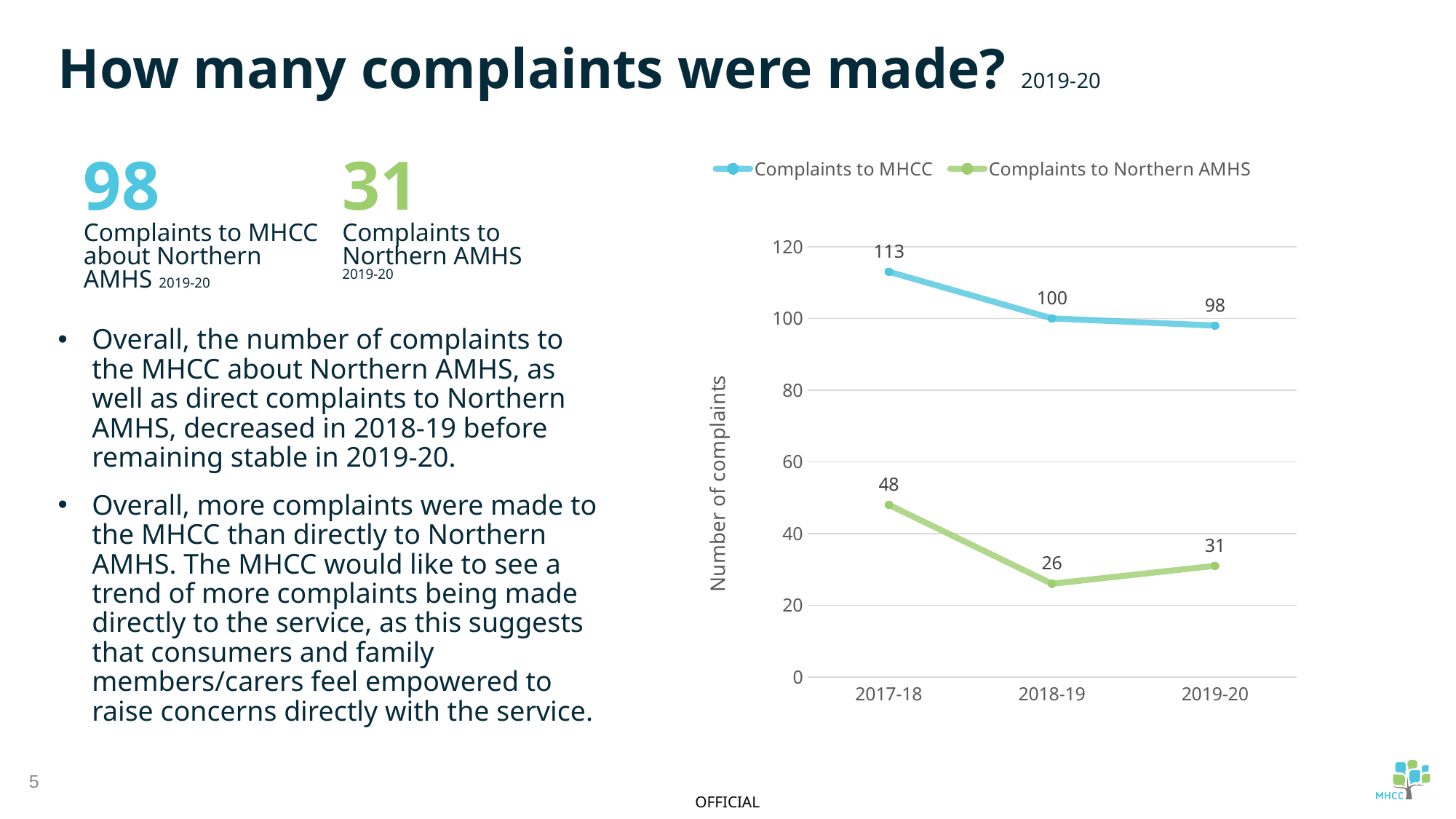
What is the value for Complaints to Northern AMHS in 2018-19? 26 What is the value for Complaints to MHCC in 2019-20? 98 Which is larger in 2017-18: Complaints to MHCC or Complaints to Northern AMHS? Complaints to MHCC What is the label on the vertical axis of the chart? Number of complaints In which year is the value for Complaints to Northern AMHS lowest? 2018-19 What is the difference between Complaints to MHCC and Complaints to Northern AMHS in 2019-20? 67 How many series does the chart legend list? 2 What kind of chart is shown on the slide? line chart How many points are plotted along the x axis for each series? 3 What is the value for Complaints to MHCC in 2017-18? 113 In which year is the value for Complaints to MHCC highest? 2017-18 Do the values for Complaints to MHCC rise or fall from 2017-18 to 2019-20? fall